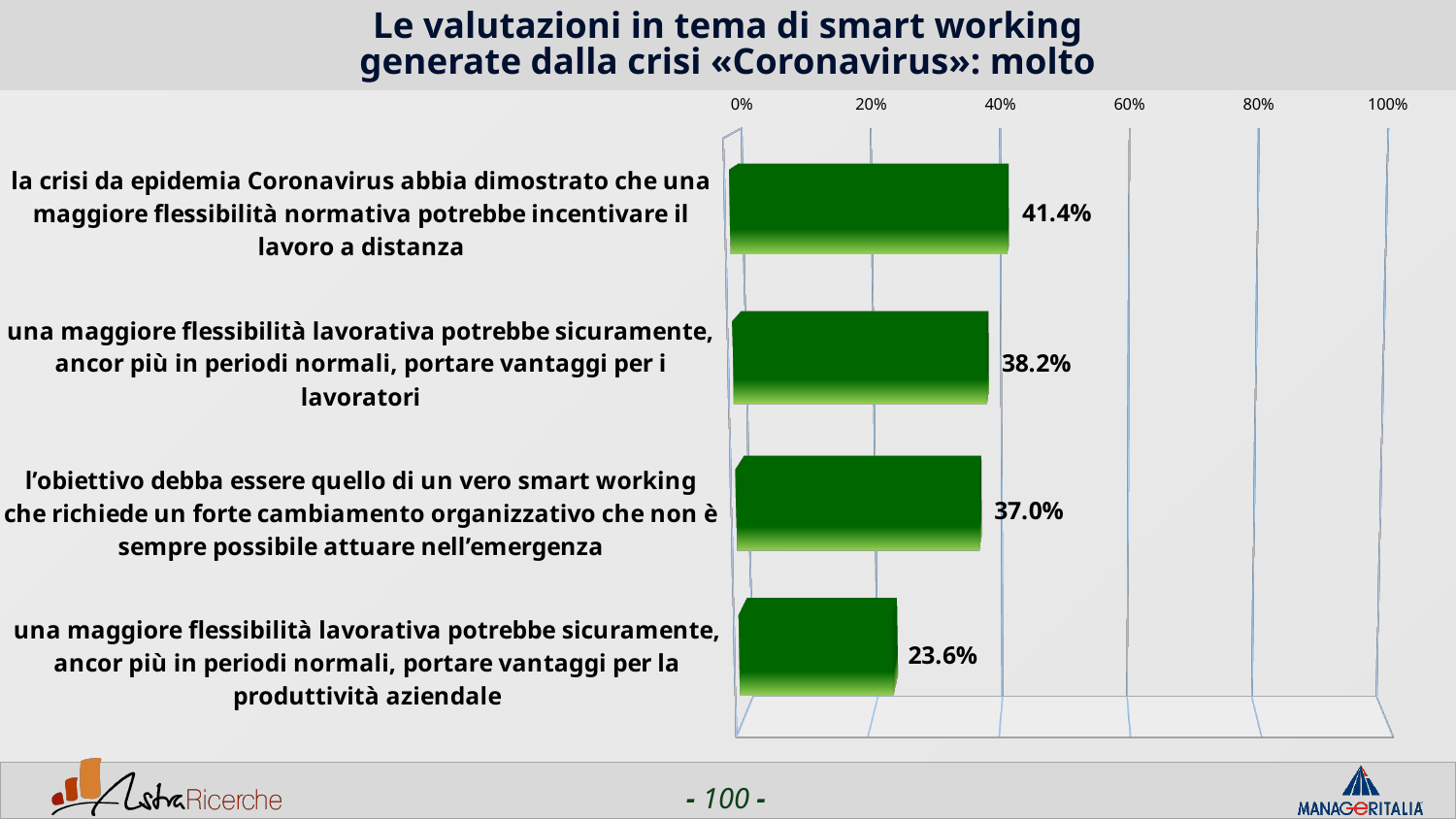
Which is larger: the value for the statement about a true smart working requiring organisational change, or the value for the statement about advantages for company productivity? the statement about a true smart working requiring organisational change (37.0%) Which statement has the highest value in the chart? la crisi da epidemia Coronavirus abbia dimostrato che una maggiore flessibilità normativa potrebbe incentivare il lavoro a distanza What is the title of the slide? Le valutazioni in tema di smart working generate dalla crisi «Coronavirus»: molto What value is shown for the statement that the goal must be true smart working requiring strong organisational change ("l'obiettivo debba essere quello di un vero smart working...")? 37.0% What is the difference between the value for advantages for workers (38.2%) and the value for advantages for company productivity (23.6%)? 14.6% What value is shown for the statement about greater work flexibility bringing advantages for workers ("...portare vantaggi per i lavoratori")? 38.2% Which statement has the lowest value in the chart? una maggiore flessibilità lavorativa potrebbe sicuramente, ancor più in periodi normali, portare vantaggi per la produttività aziendale What value is shown for the statement about greater work flexibility bringing advantages for company productivity ("...portare vantaggi per la produttività aziendale")? 23.6% What type of chart is shown on the slide? bar chart What value is shown for the statement that the Coronavirus crisis demonstrated that greater regulatory flexibility could encourage remote work ("la crisi da epidemia Coronavirus abbia dimostrato che una maggiore flessibilità normativa potrebbe incentivare il lavoro a distanza")? 41.4% What is the difference between the highest value (41.4%) and the lowest value (23.6%) in the chart? 17.8% How many statements (bars) are shown in the chart? 4